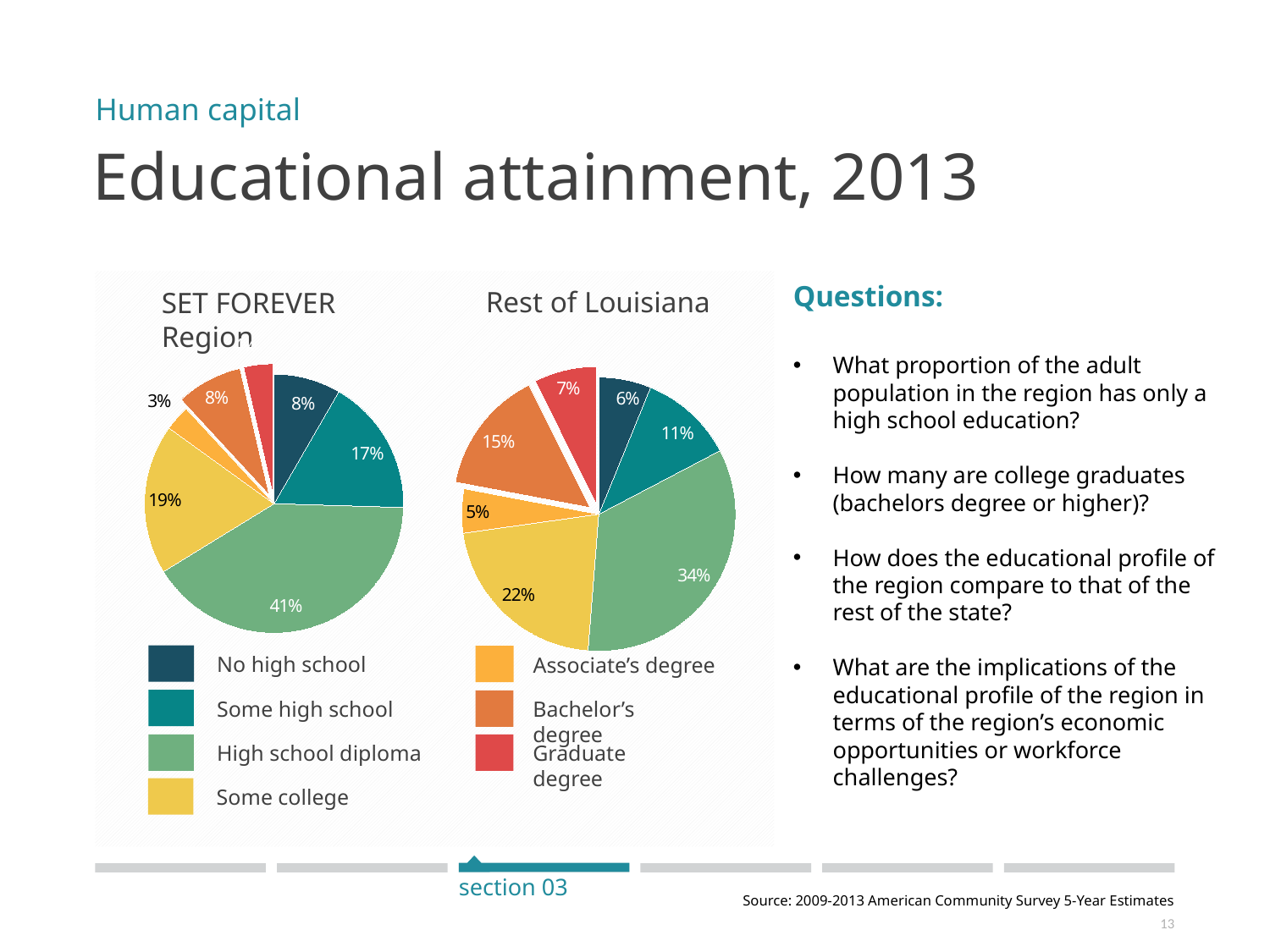
In the SET FOREVER Region pie chart, what share has some high school? 17% What type of chart is used to show educational attainment on this slide? Pie chart In the SET FOREVER Region pie chart, what share of the population has a high school diploma? 41% How many categories does the legend list for the pie charts? 7 In the Rest of Louisiana pie chart, what share has a graduate degree? 7% In the Rest of Louisiana pie chart, what share of the population has a bachelor's degree? 15% What is the difference between the high school diploma share in the SET FOREVER Region chart and in the Rest of Louisiana chart? 7 percentage points Which colour represents 'No high school' in the legend? Dark navy blue In the Rest of Louisiana pie chart, which category has the largest slice? High school diploma Which chart shows a larger share with some college: SET FOREVER Region or Rest of Louisiana? Rest of Louisiana In the SET FOREVER Region pie chart, which labelled category has the smallest slice? Associate's degree In the Rest of Louisiana pie chart, what is the combined share of bachelor's and graduate degrees? 22%